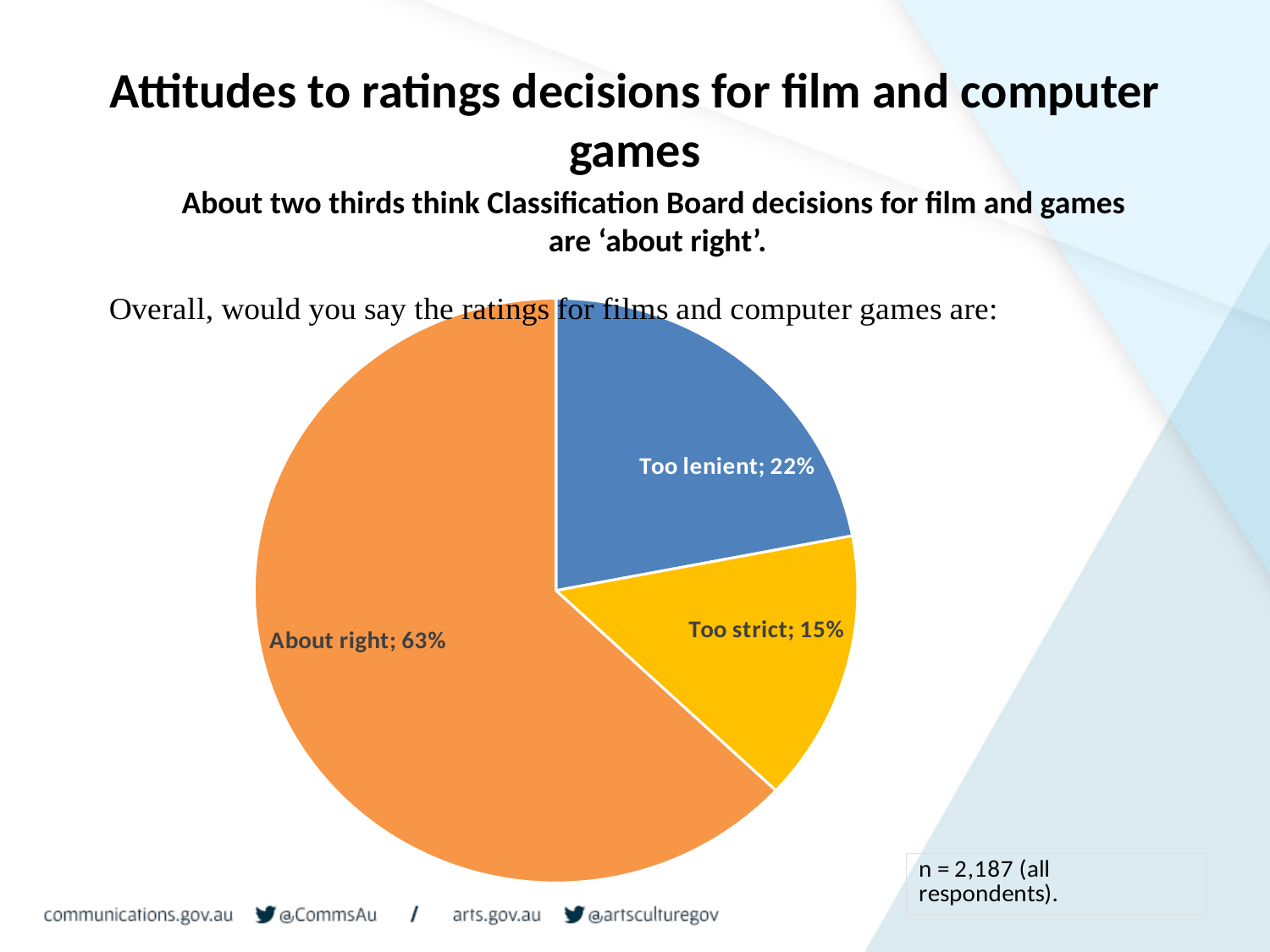
Which response has the largest share of the pie? About right What is the difference in percentage points between 'About right' and 'Too lenient'? 41 What colour is the 'About right' slice? orange What percentage of respondents said the ratings are 'Too lenient'? 22% What kind of chart is shown on the slide? pie chart What percentage of respondents said the ratings are 'Too strict'? 15% How many slices does the pie chart have? 3 Which response has the smallest share of the pie? Too strict What percentage of respondents said the ratings are 'About right'? 63% What is the difference in percentage points between 'Too lenient' and 'Too strict'? 7 What is the sample size (n) stated on the slide? 2,187 Which is larger, the share for 'Too lenient' or the share for 'Too strict'? Too lenient